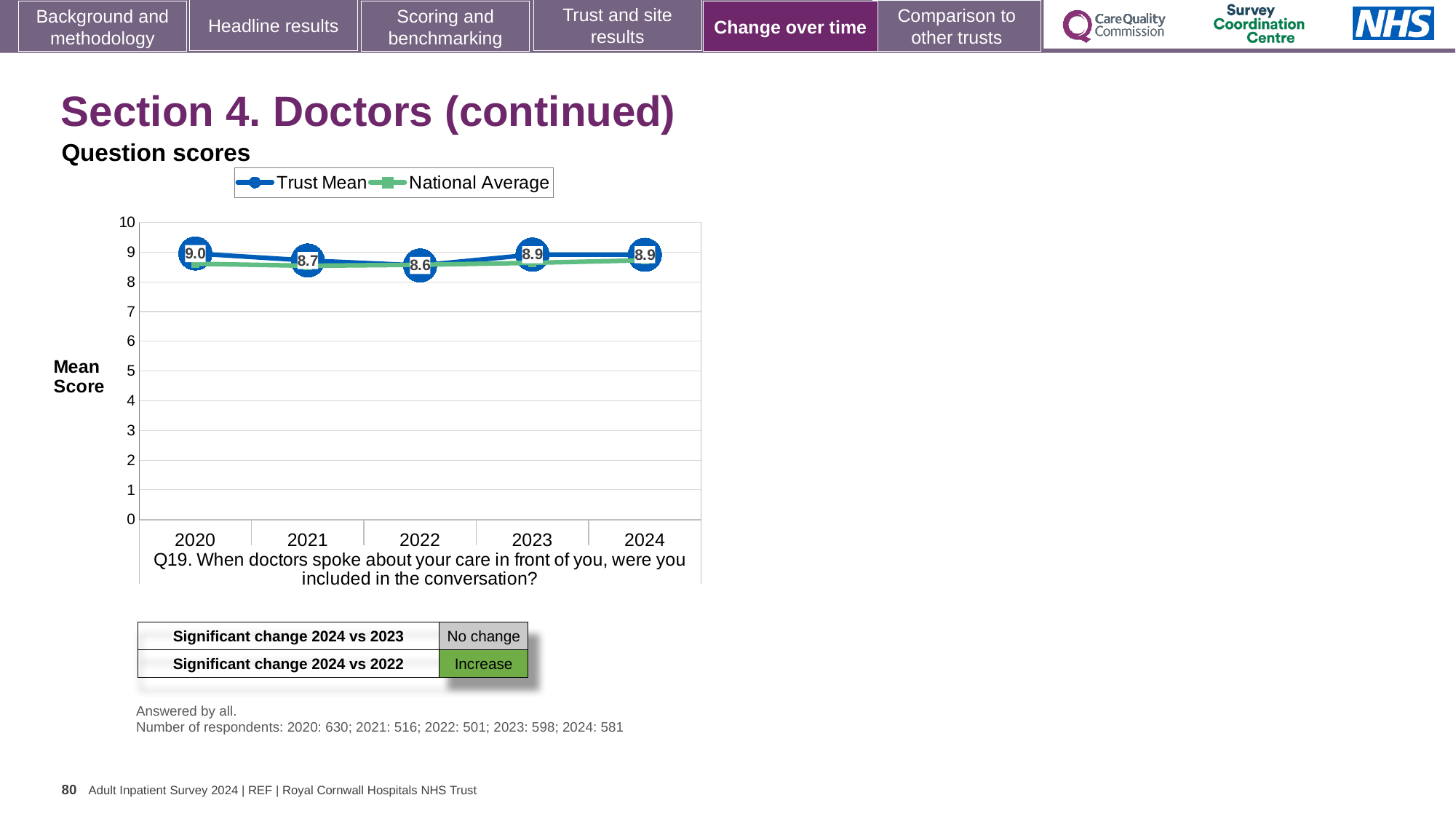
In which year is the Trust Mean score lowest? 2022 What is the Trust Mean score for 2020? 9.0 How many years are plotted on the x axis? 5 How many series does the legend list? 2 What are the two series named in the legend? Trust Mean and National Average What is the Trust Mean score for 2022? 8.6 In which year is the Trust Mean score highest? 2020 Which year has the larger Trust Mean score, 2021 or 2023? 2023 Is the National Average value for 2022 greater or less than 5? greater What is the difference between the Trust Mean score in 2020 and in 2022? 0.4 What kind of chart is shown on the slide? Line chart What is the Trust Mean score for 2024? 8.9